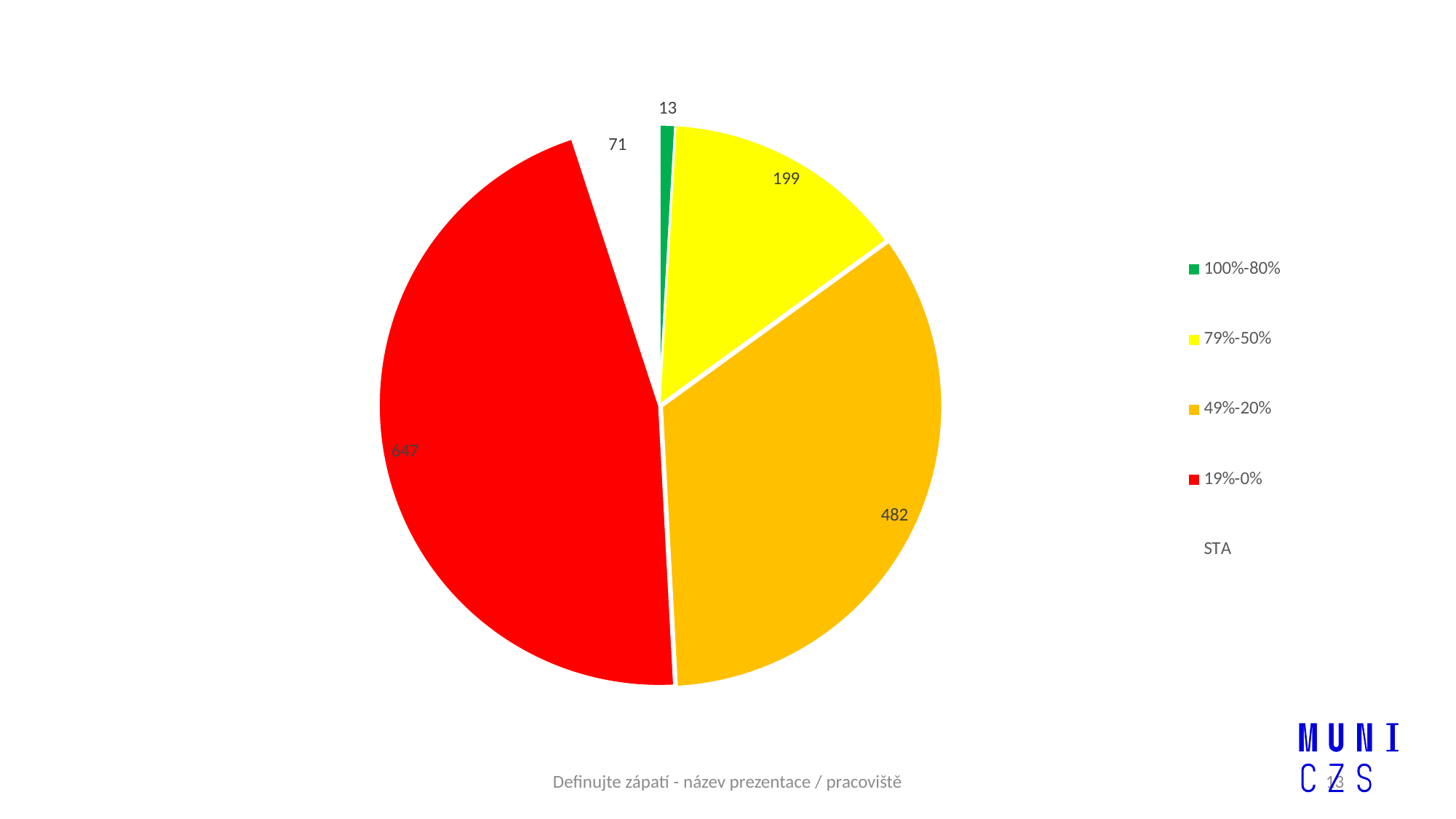
Which is larger, the 79%-50% slice or the 100%-80% slice? 79%-50% What kind of chart is shown on the slide? pie chart Which legend category has the largest slice? 19%-0% What is the difference between the 19%-0% slice and the 49%-20% slice? 165 How many data labels are printed on the pie chart? 5 Which legend category has the smallest slice? 100%-80% What is the value of the 79%-50% slice? 199 What colour is the 19%-0% slice? red What is the value of the 100%-80% slice? 13 What is the difference between the 49%-20% slice and the 79%-50% slice? 283 What is the value of the 49%-20% slice? 482 What is the value of the 19%-0% slice? 647